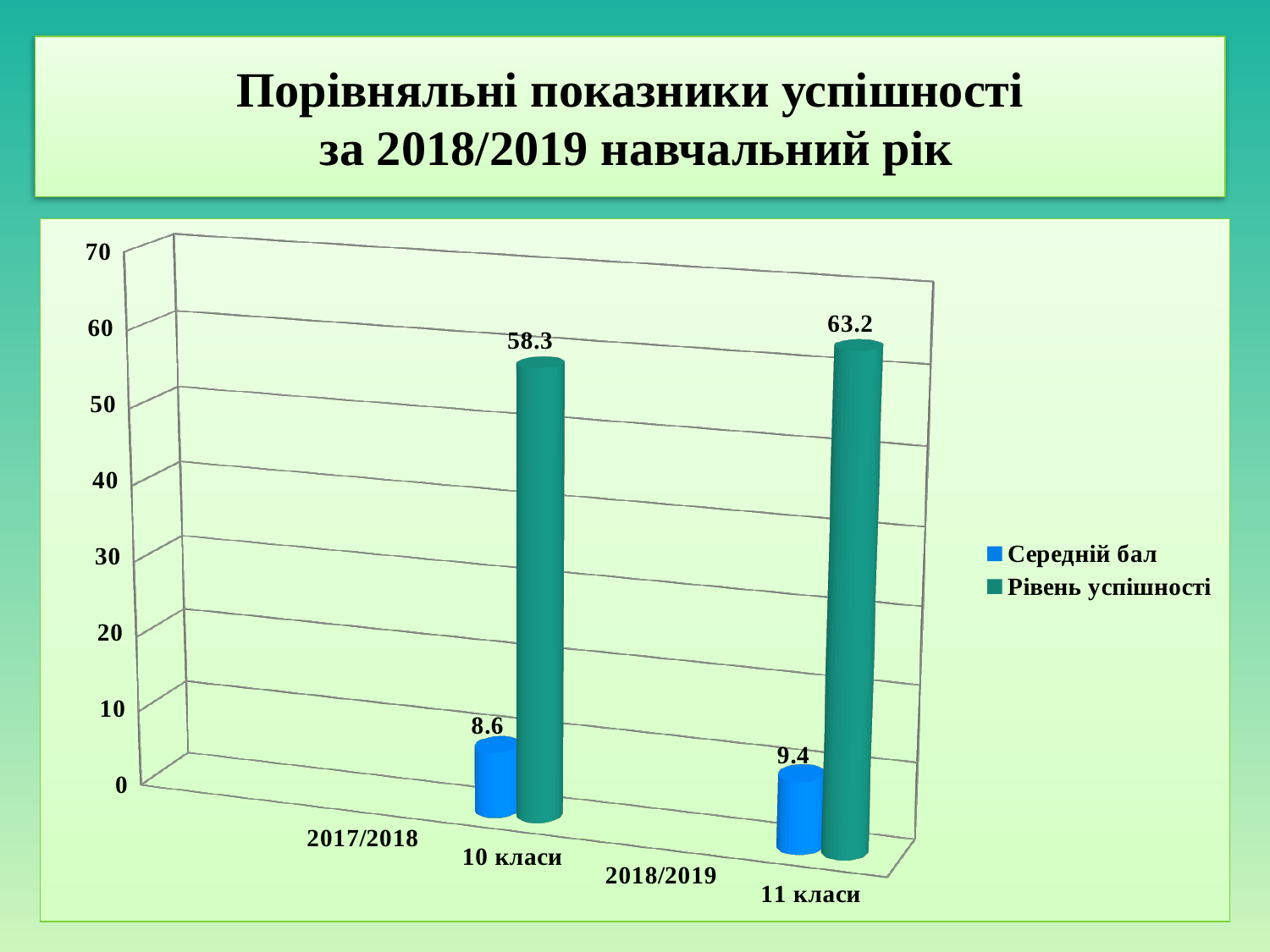
Which colour represents the Середній бал series? Blue Is the Рівень успішності value for 2017/2018 10 класи greater or less than 50? greater What is the value of Рівень успішності for 2018/2019 11 класи? 63.2 Which category has the lower Середній бал value? 2017/2018 10 класи Which category has the higher Рівень успішності value? 2018/2019 11 класи What is the difference between the Середній бал values for 2018/2019 11 класи and 2017/2018 10 класи? 0.8 What is the value of Рівень успішності for 2017/2018 10 класи? 58.3 What is the difference between the Рівень успішності values for 2018/2019 11 класи and 2017/2018 10 класи? 4.9 What is the value of Середній бал for 2017/2018 10 класи? 8.6 How many series does the legend list? 2 What kind of chart is shown on the slide? Bar chart What is the value of Середній бал for 2018/2019 11 класи? 9.4